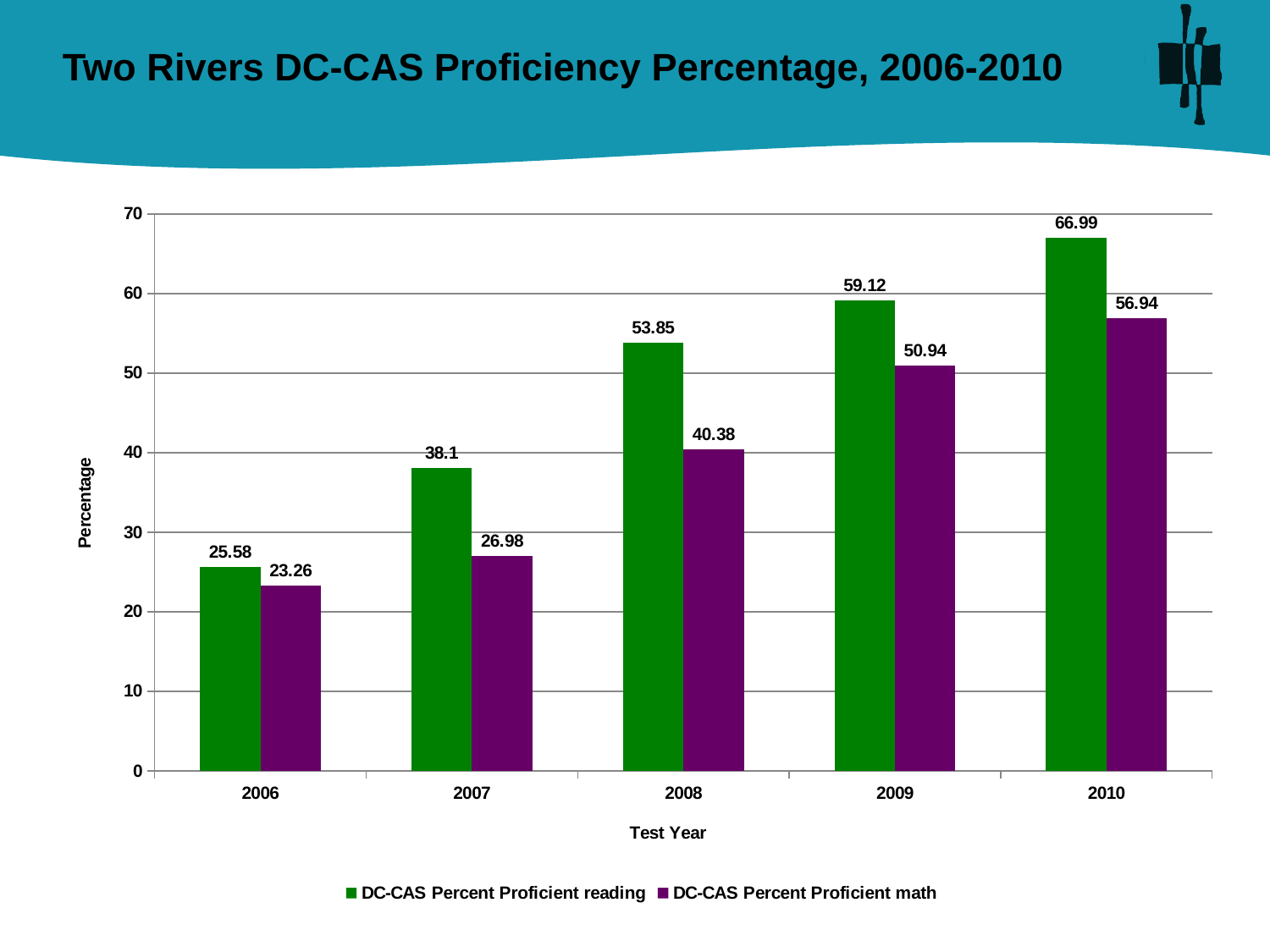
Which test year has the highest DC-CAS Percent Proficient reading value? 2010 What kind of chart is shown on the slide? Bar chart What is the difference between the DC-CAS Percent Proficient reading values for 2010 and 2009? 7.87 Do the DC-CAS Percent Proficient math values rise or fall from 2006 to 2010? Rise Which is larger in 2007, the reading proficiency percentage or the math proficiency percentage? Reading Which test year has the lowest DC-CAS Percent Proficient math value? 2006 What is the DC-CAS Percent Proficient math value for 2006? 23.26 How many test years are shown on the x axis? 5 What is the difference between the reading and math proficiency percentages in 2008? 13.47 What is the DC-CAS Percent Proficient reading value for 2008? 53.85 How many series does the legend list? 2 What is the DC-CAS Percent Proficient math value for 2010? 56.94